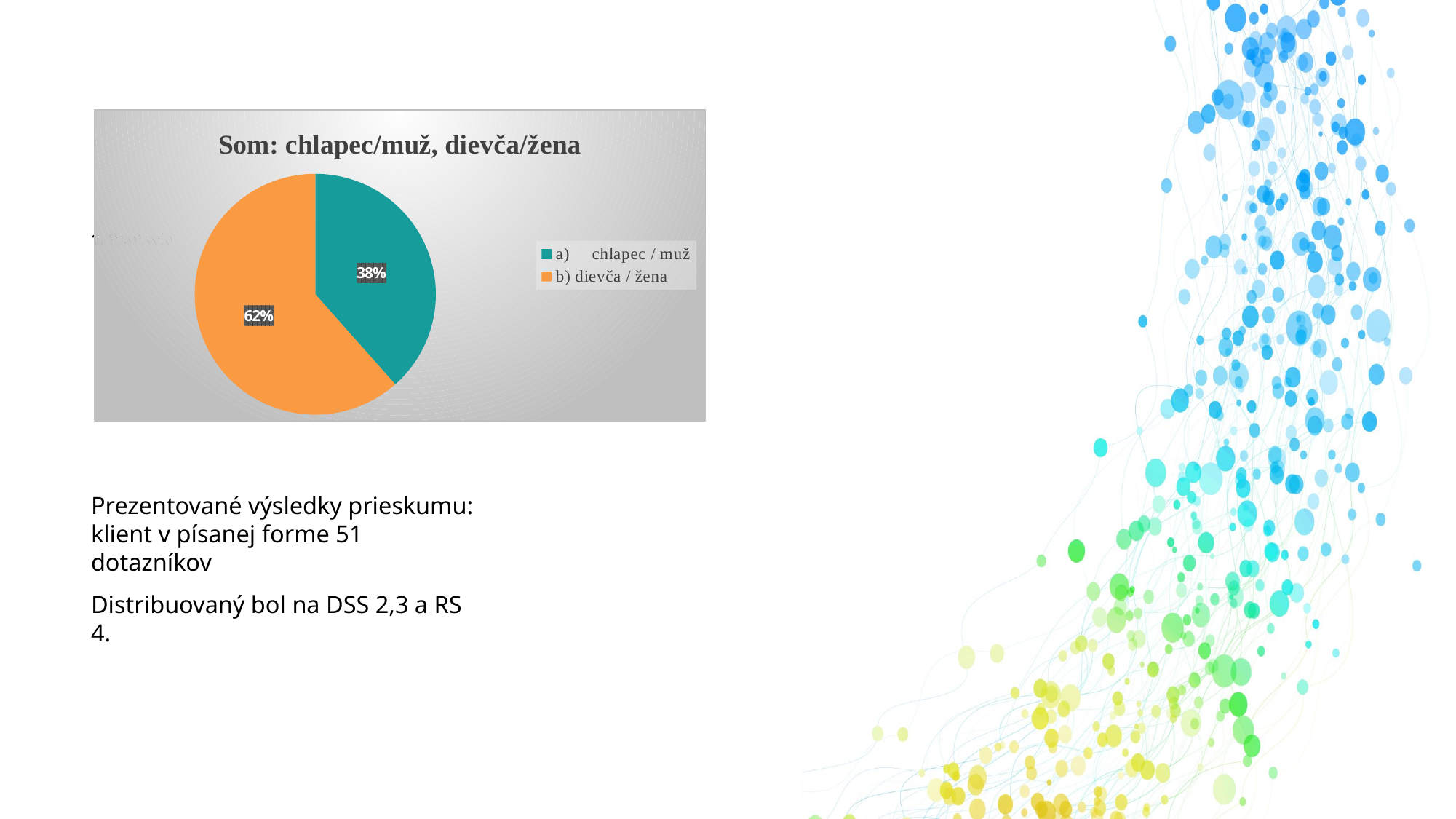
How many slices does the pie chart have? 2 Which is larger: the slice for "a) chlapec / muž" or the slice for "b) dievča / žena"? b) dievča / žena Which category has the largest slice of the pie? b) dievča / žena What kind of chart is shown on the slide? pie chart What colour is the slice for "b) dievča / žena"? orange What share of the pie does "b) dievča / žena" take? 62% What is the difference in percentage points between the "b) dievča / žena" slice and the "a) chlapec / muž" slice? 24 What is the title of the chart? Som: chlapec/muž, dievča/žena What share of the pie does "a) chlapec / muž" take? 38% How many entries does the legend list? 2 Which category has the smallest slice of the pie? a) chlapec / muž